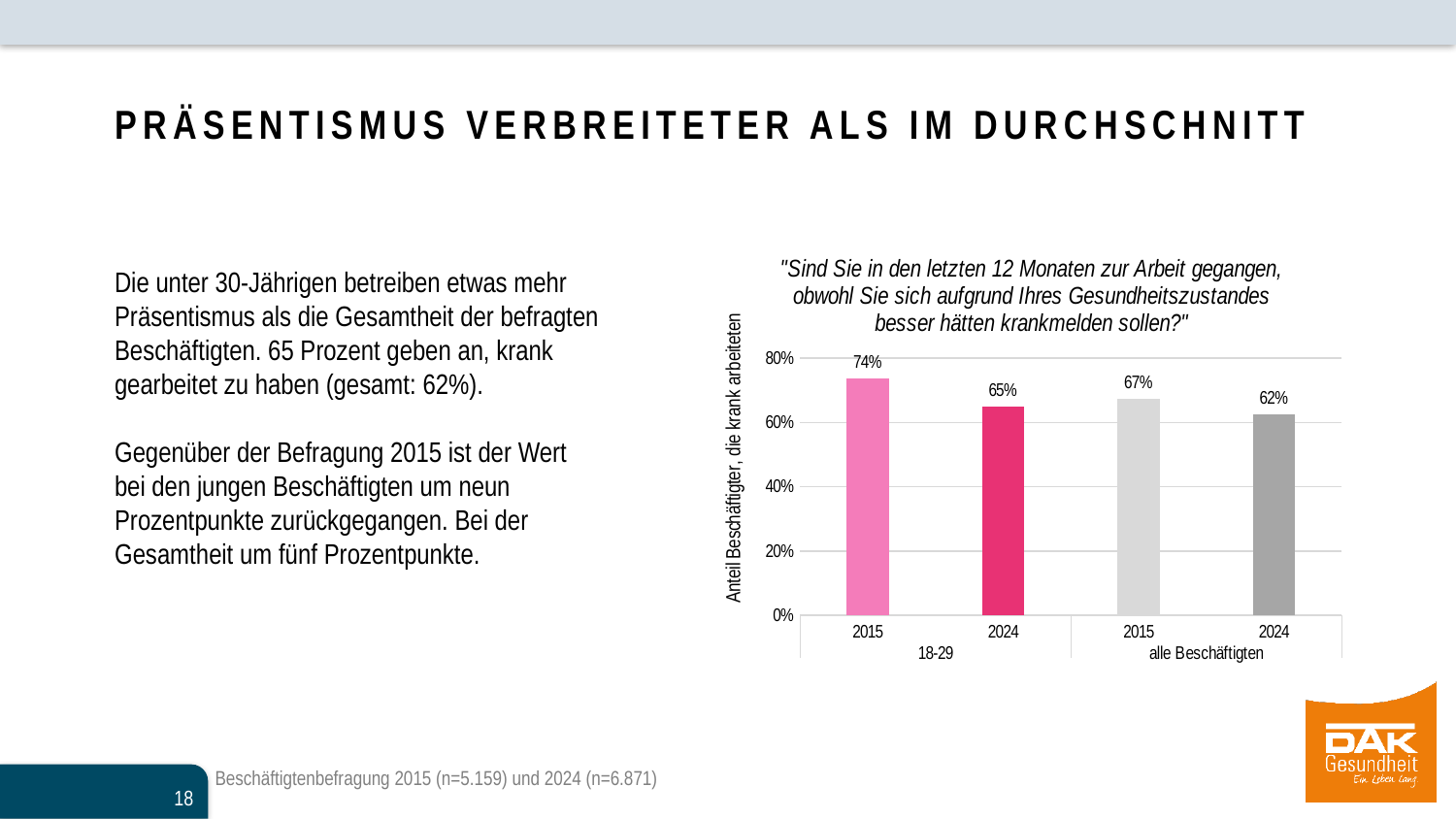
What kind of chart is shown on the slide? Bar chart What is the value for 2024 for alle Beschäftigten? 62% How many bars are shown in the chart? 4 What is the label of the vertical axis? Anteil Beschäftigter, die krank arbeiteten What is the value for 2024 in the 18-29 group? 65% What is the value for 2015 for alle Beschäftigten? 67% Which bar has the lowest value? 2024, alle Beschäftigten What is the value for 2015 in the 18-29 group? 74% Which is larger: the 2024 value for 18-29 or the 2024 value for alle Beschäftigten? 2024 value for 18-29 What is the difference between the 2015 and 2024 values for the 18-29 group? 9 percentage points What is the difference between the 2015 and 2024 values for alle Beschäftigten? 5 percentage points Which bar has the highest value? 2015, 18-29